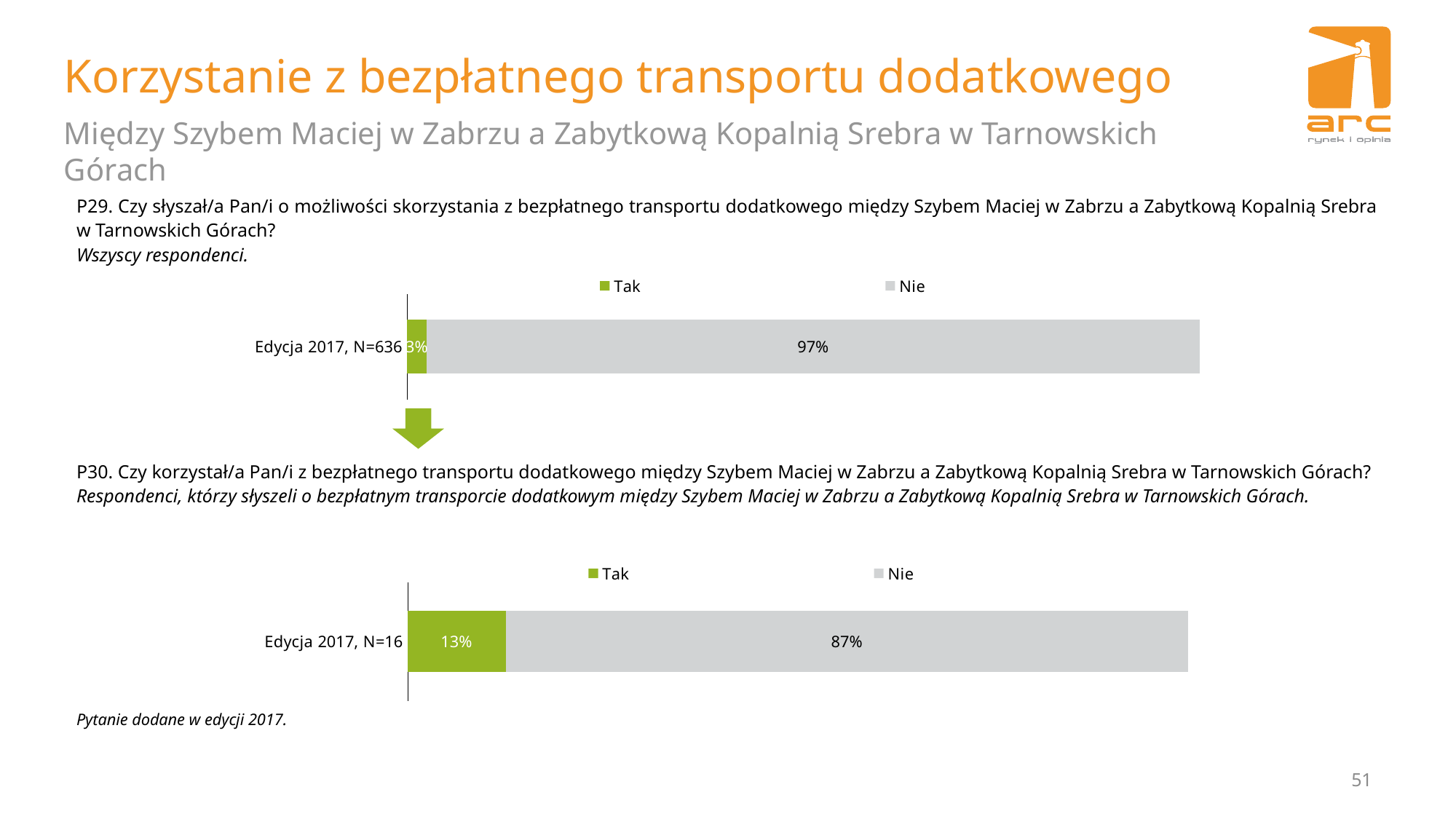
In the top chart (P29), what is the value for Nie for Edycja 2017, N=636? 97% In the bottom chart (P30), what is the difference between the Nie and Tak values? 74% In the bottom chart (P30), which series has the larger value, Tak or Nie? Nie In the bottom chart (P30), what is the total of the stacked bar for Edycja 2017, N=16? 100% What kind of chart is the top chart (P29)? Stacked bar chart In the top chart (P29), what is the difference between the Nie and Tak values? 94% In the bottom chart (P30), what is the value for Nie for Edycja 2017, N=16? 87% In the top chart (P29), what colour represents the Tak series? Green In the top chart (P29), what is the value for Tak for Edycja 2017, N=636? 3% How many series does the legend of the bottom chart (P30) list? 2 In the bottom chart (P30), what is the value for Tak for Edycja 2017, N=16? 13% In the top chart (P29), which series has the smaller value, Tak or Nie? Tak